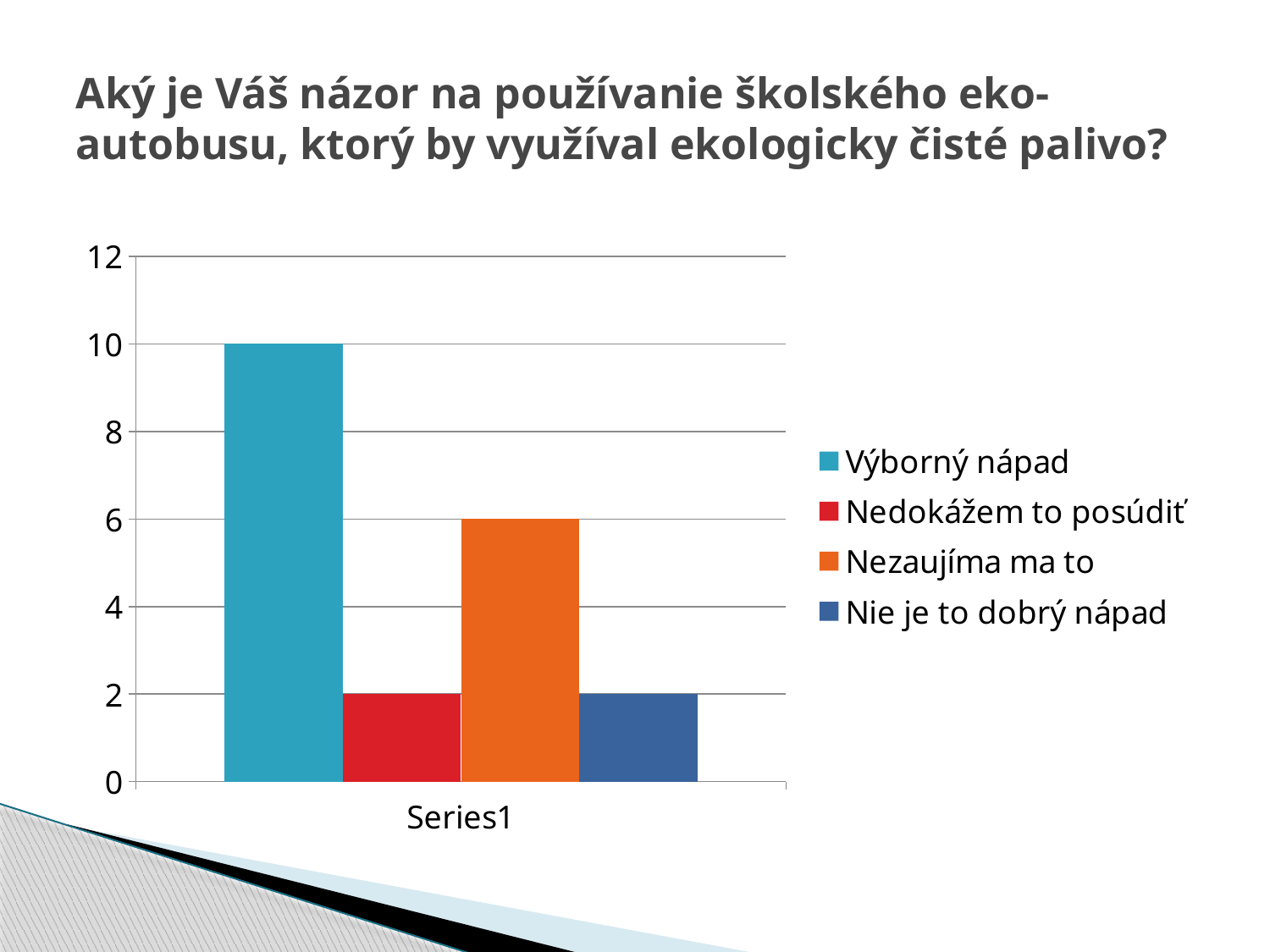
What kind of chart is shown on the slide? bar chart What is the difference between the values for "Výborný nápad" and "Nezaujíma ma to"? 4 What is the value for "Nezaujíma ma to"? 6 Is the value for "Výborný nápad" greater or less than 8? greater What colour is the bar for "Nezaujíma ma to"? orange Which legend entry has the highest value? Výborný nápad How many entries does the legend list? 4 What is the value for "Nie je to dobrý nápad"? 2 What is the value for "Výborný nápad"? 10 What is the value for "Nedokážem to posúdiť"? 2 What is the label shown on the x axis below the bars? Series1 Which is larger, the value for "Nezaujíma ma to" or the value for "Nie je to dobrý nápad"? Nezaujíma ma to